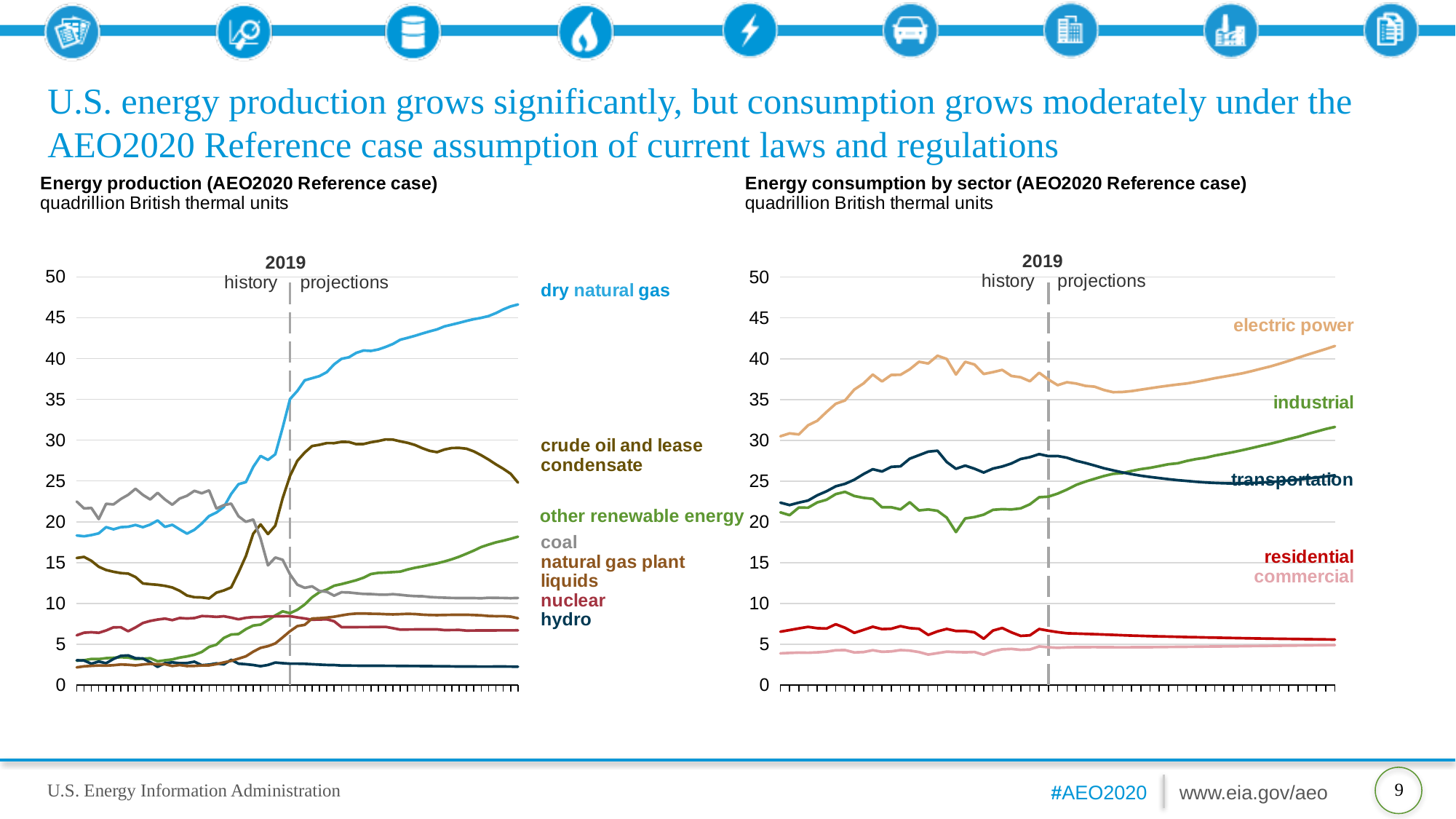
What kind of chart is the Energy production chart on the left? line chart On the Energy production chart, which series has the lowest value at the end of the projection period? hydro On the Energy consumption by sector chart, is the final projected value for industrial greater or less than 30? greater What year separates history from projections on both charts? 2019 On the Energy consumption by sector chart, which sector has the highest consumption at the end of the projection period? electric power On the Energy consumption by sector chart, which sector has the lowest consumption at the end of the projection period? commercial On the Energy production chart, is the final projected value for dry natural gas greater or less than 40? greater On the Energy production chart, does the dry natural gas series rise or fall over the projection period? rise How many sectors are labelled on the Energy consumption by sector chart? 5 How many series are labelled on the Energy production chart? 7 On the Energy production chart, which series has the highest value at the end of the projection period? dry natural gas On the Energy consumption by sector chart, does the transportation series rise or fall over the projection period? fall